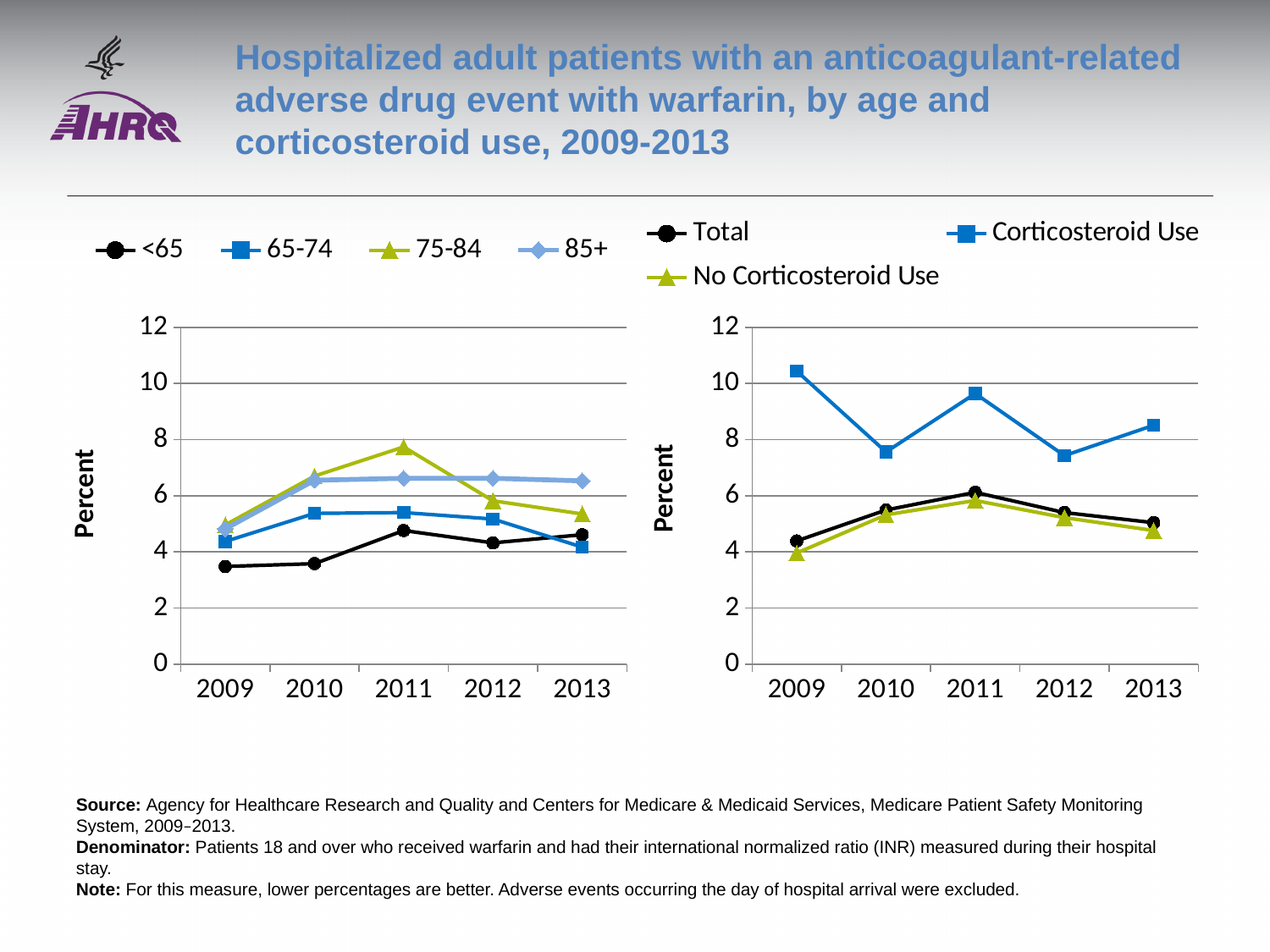
In the left chart (by age group), does the value for <65 rise or fall from 2009 to 2011? rise In the right chart (by corticosteroid use), which series has the highest value in 2009? Corticosteroid Use In the right chart (by corticosteroid use), which is larger in 2011, Corticosteroid Use or Total? Corticosteroid Use In the right chart (by corticosteroid use), is the value for Corticosteroid Use in 2012 greater or less than 8? less In the left chart (by age group), is the value for <65 in 2009 greater or less than 4? less What kind of chart is the left chart (by age group)? line chart In the left chart (by age group), is the value for 75-84 in 2011 greater or less than 6? greater In the left chart (by age group), which age group has the lowest value in 2009? <65 How many series does the legend of the left chart (by age group) list? 4 How many years are shown on the x axis of the left chart (by age group)? 5 In the left chart (by age group), which age group has the highest value in 2011? 75-84 How many series does the legend of the right chart (by corticosteroid use) list? 3